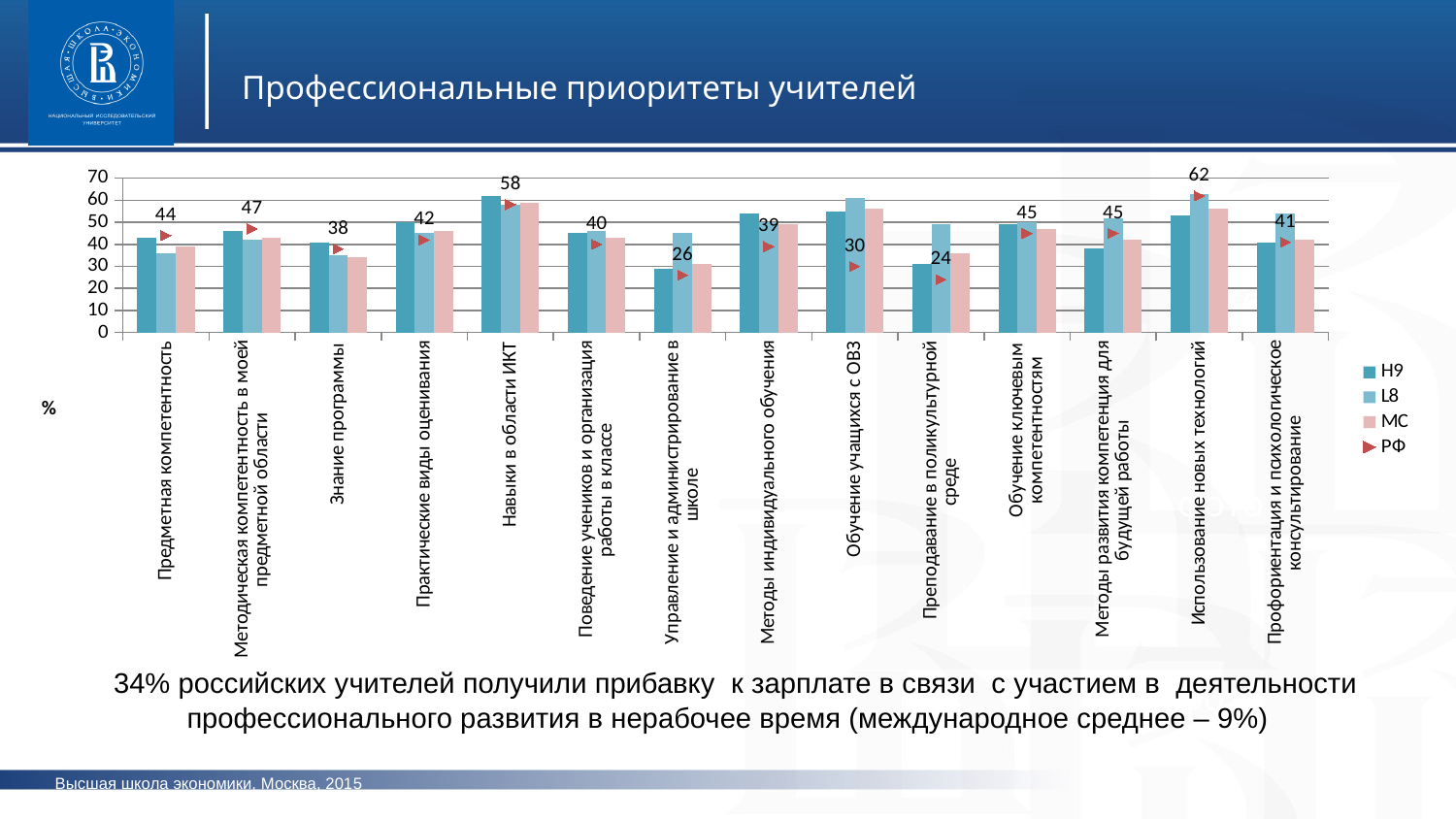
What is the РФ value for Преподавание в поликультурной среде? 24 What is the РФ value for Знание программы? 38 Which category has the lowest РФ value? Преподавание в поликультурной среде What is the РФ value for Использование новых технологий? 62 How many categories are shown on the x axis? 14 Which has the larger РФ value: Методическая компетентность в моей предметной области or Предметная компетентность? Методическая компетентность в моей предметной области What kind of chart is shown on the slide? bar chart How many series does the legend list? 4 Which category has the highest РФ value? Использование новых технологий Is the L8 value for Обучение учащихся с ОВЗ greater or less than 50? greater What is the difference between the РФ values for Навыки в области ИКТ and Управление и администрирование в школе? 32 What is the РФ value for Навыки в области ИКТ? 58